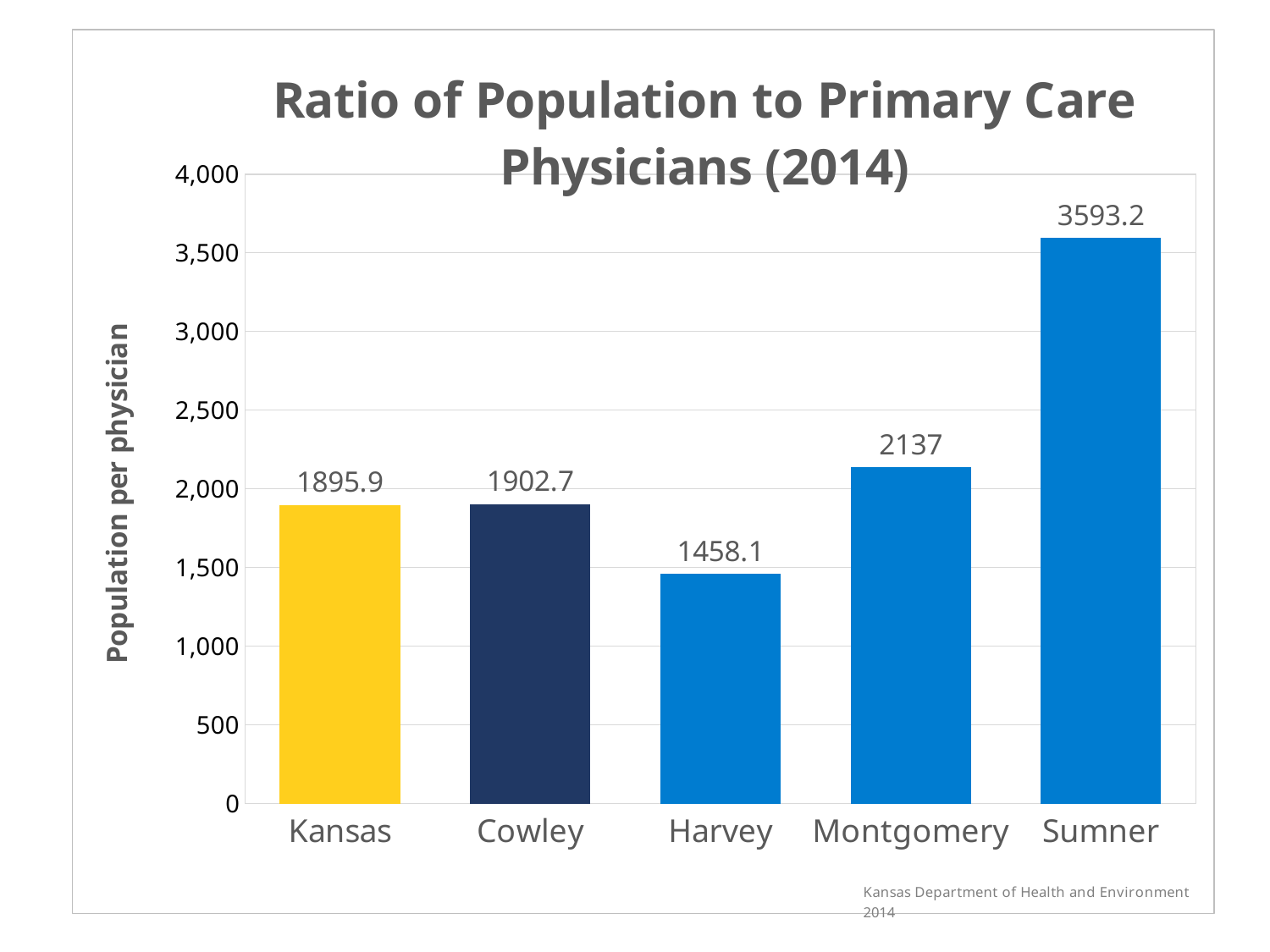
What type of chart is shown on the slide? Bar chart What is the value shown for Harvey? 1458.1 What is the value shown for Montgomery? 2137 What is the ratio of population to primary care physicians for Kansas? 1895.9 Which category has the lowest population per physician? Harvey Which is larger, the value for Montgomery or the value for Harvey? Montgomery How many categories are shown on the x axis? 5 What is the value shown for Sumner? 3593.2 What is the difference between the values for Montgomery and Kansas? 241.1 Is the value for Sumner greater or less than 3,000? greater Which category has the highest population per physician? Sumner What is the difference between the values for Sumner and Harvey? 2135.1